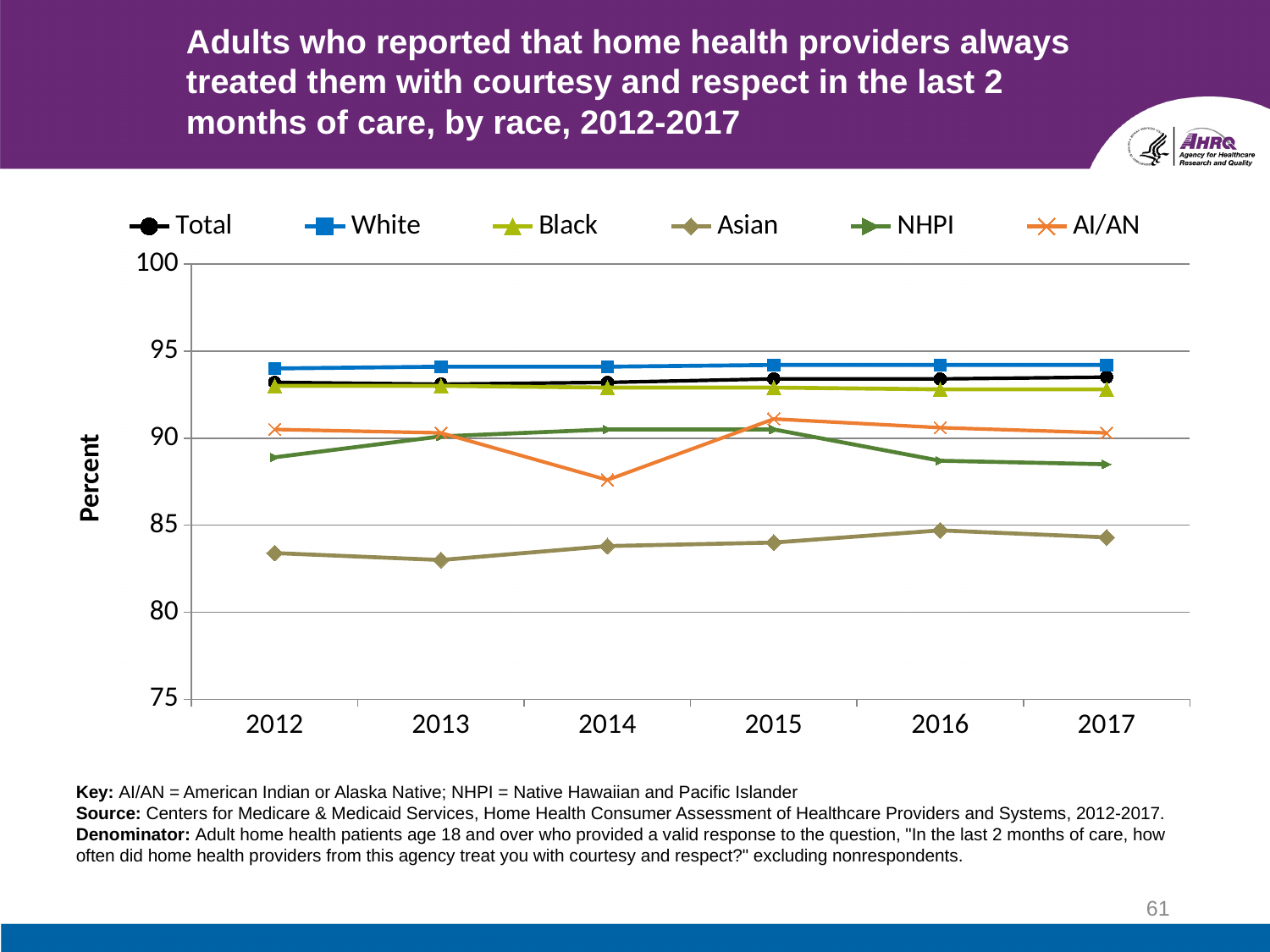
In 2014, which is larger: the value for NHPI or the value for AI/AN? NHPI Did the AI/AN value fall or rise from 2013 to 2014? fall What type of chart is shown on the slide? line chart Which series has the highest values across all years? White How many series does the legend list? 6 Is the value for Asian in 2012 greater or less than 85? less How many years are plotted along the x axis? 6 What is the label on the y axis? Percent Is the value for NHPI in 2012 greater or less than 90? less Which race group has the lowest values across all years? Asian Is the value for White in 2015 greater or less than 90? greater